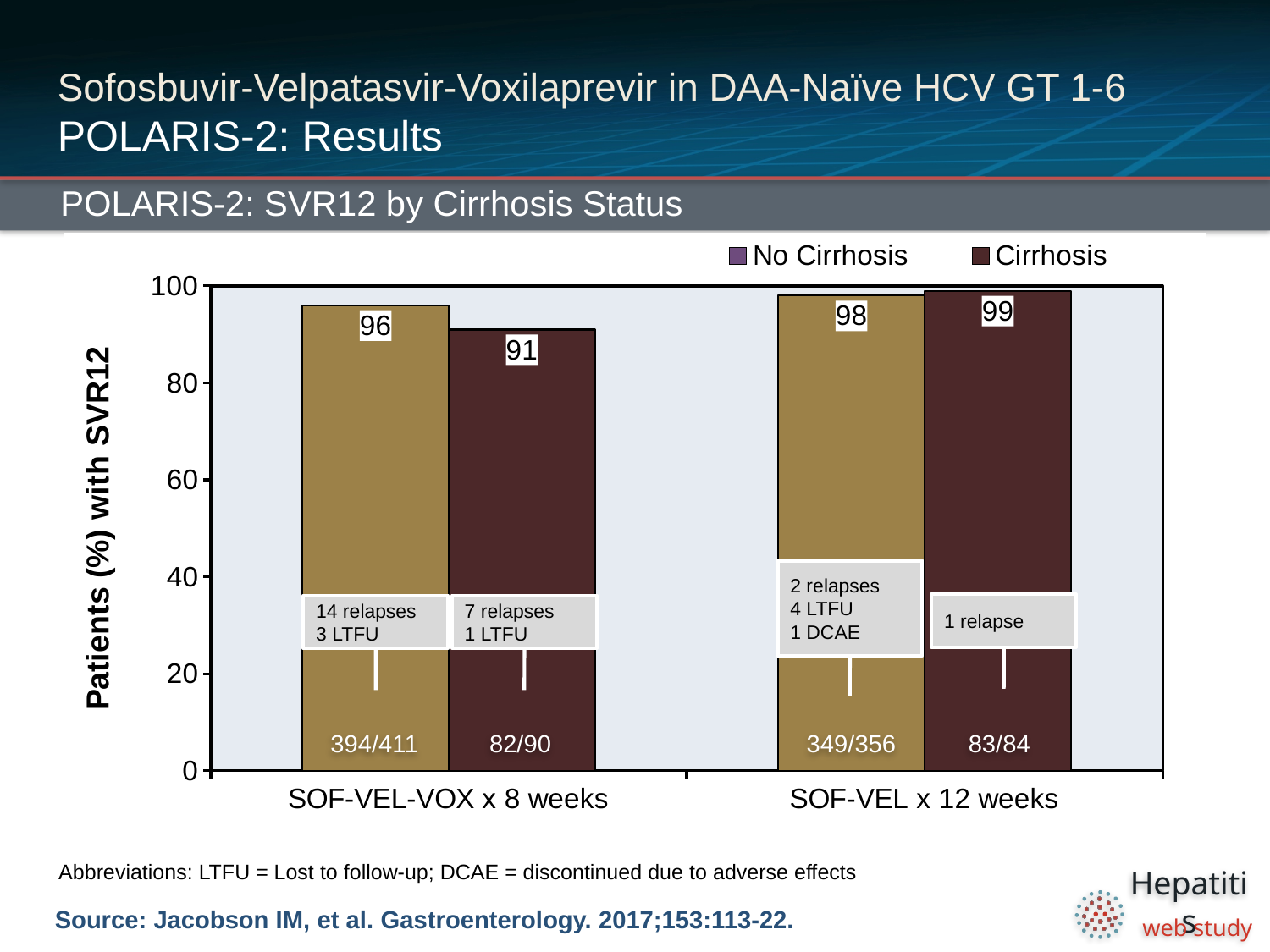
What kind of chart is shown on the slide? Bar chart How many series does the legend list? 2 Which bar shows the highest SVR12 rate? Cirrhosis, SOF-VEL x 12 weeks Which bar shows the lowest SVR12 rate? Cirrhosis, SOF-VEL-VOX x 8 weeks What is the difference in SVR12 rate between No Cirrhosis and Cirrhosis patients treated with SOF-VEL-VOX x 8 weeks? 5 What is the SVR12 rate for No Cirrhosis patients treated with SOF-VEL-VOX x 8 weeks? 96 How many patients achieved SVR12 out of the total in the Cirrhosis group treated with SOF-VEL-VOX x 8 weeks? 82/90 What is the SVR12 rate for No Cirrhosis patients treated with SOF-VEL x 12 weeks? 98 Which is larger: the SVR12 rate for No Cirrhosis patients on SOF-VEL-VOX x 8 weeks or on SOF-VEL x 12 weeks? SOF-VEL x 12 weeks How many relapses occurred among No Cirrhosis patients treated with SOF-VEL-VOX x 8 weeks? 14 relapses What is the SVR12 rate for Cirrhosis patients treated with SOF-VEL x 12 weeks? 99 What is the SVR12 rate for Cirrhosis patients treated with SOF-VEL-VOX x 8 weeks? 91